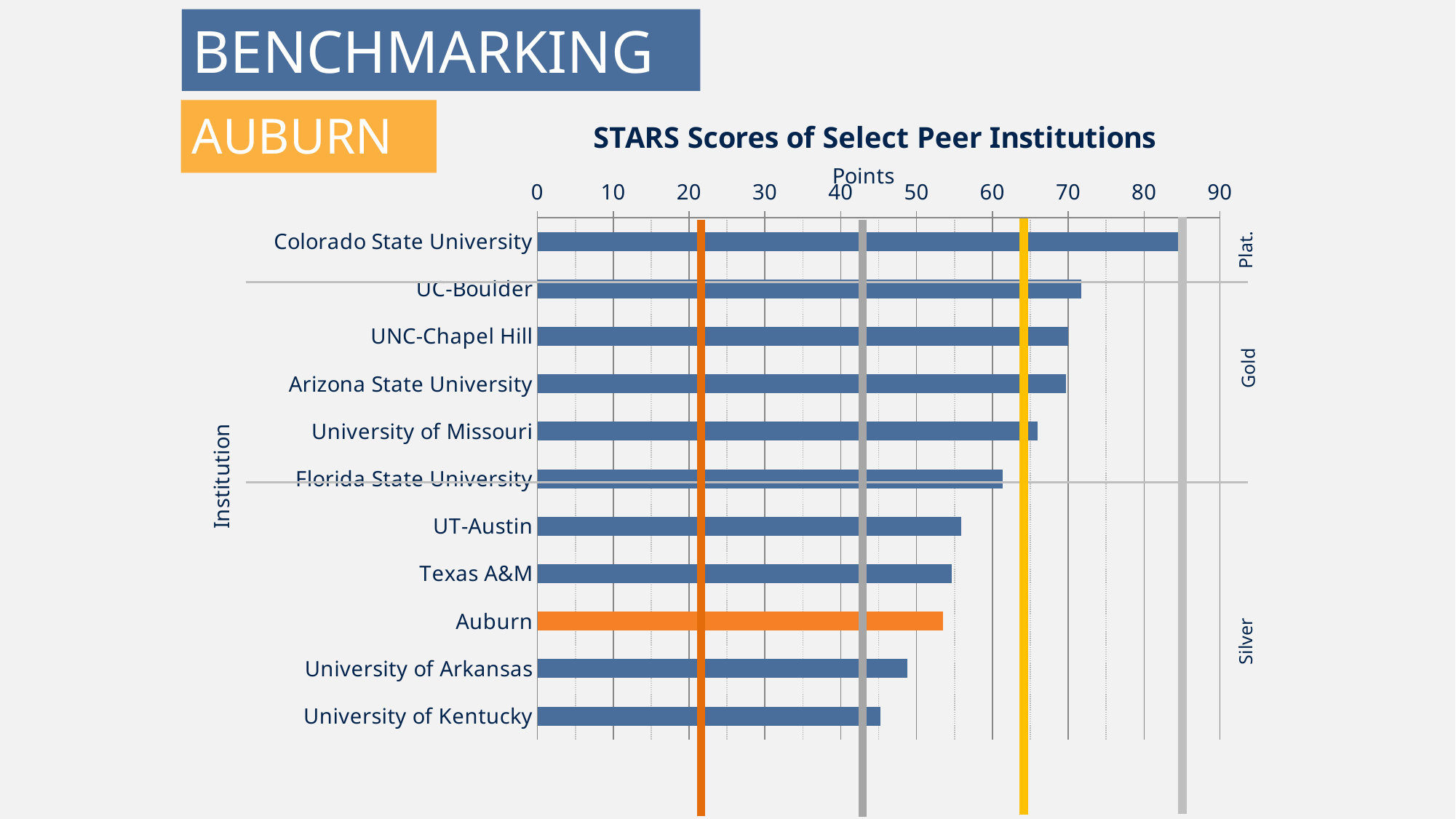
What is the label on the horizontal axis of the chart? Points Which has a higher STARS score, Auburn or University of Arkansas? Auburn What is the title of the chart? STARS Scores of Select Peer Institutions Is the value for Auburn greater or less than 50? greater Is the value for UT-Austin greater or less than 60? less What kind of chart is shown on the slide? Bar chart Which institution has the highest STARS score? Colorado State University Which institution has the lowest STARS score? University of Kentucky Is the value for Colorado State University greater or less than 80? greater How many institutions are plotted in the chart? 11